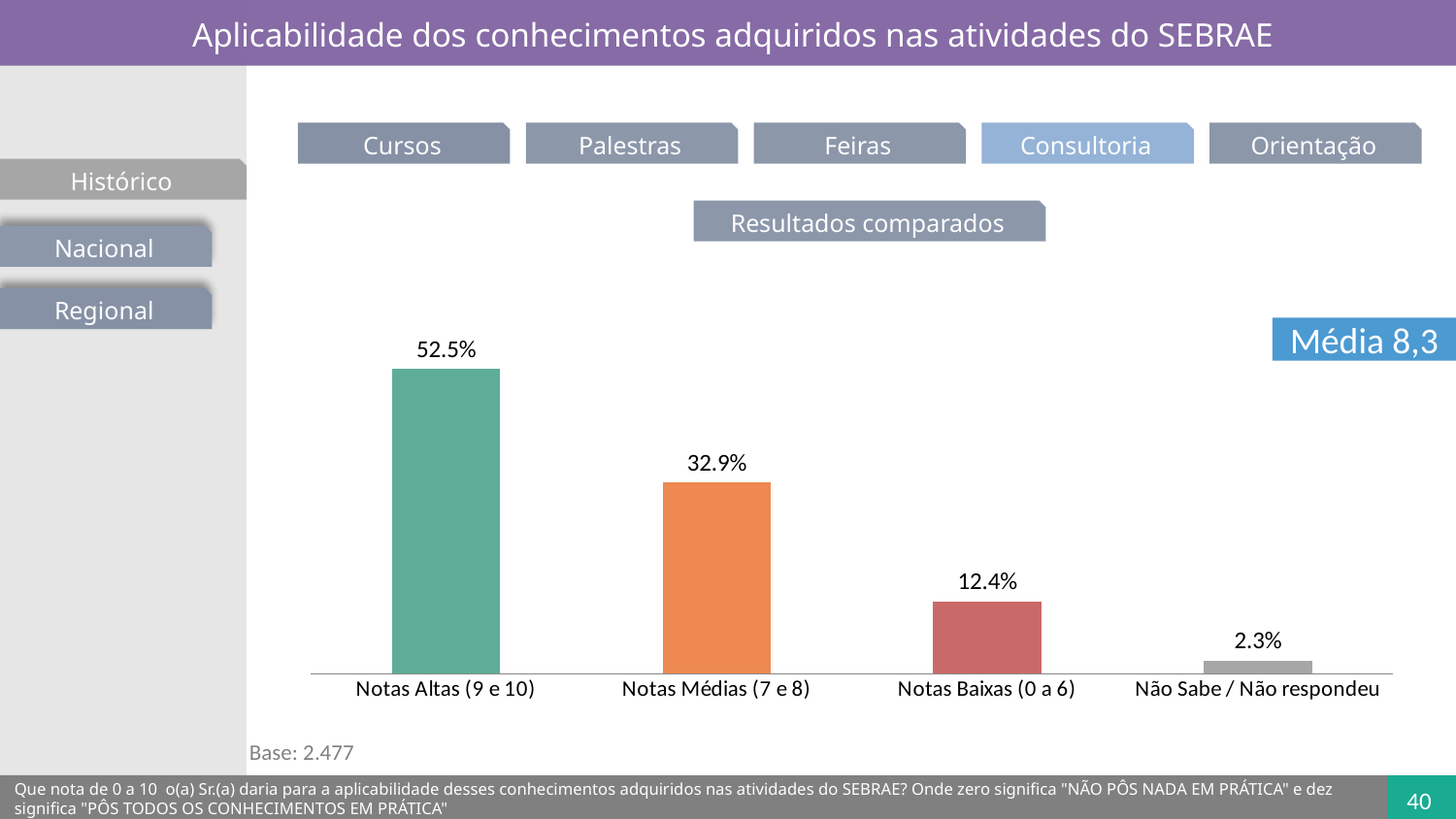
What is the difference between Notas Baixas (0 a 6) and Não Sabe / Não respondeu? 10.1% What is the value for Não Sabe / Não respondeu? 2.3% What is the difference between Notas Altas (9 e 10) and Notas Médias (7 e 8)? 19.6% What is the value for Notas Baixas (0 a 6)? 12.4% What is the value for Notas Altas (9 e 10)? 52.5% How many categories are shown in the chart? 4 What kind of chart is shown on the slide? Bar chart What is the value for Notas Médias (7 e 8)? 32.9% What average (Média) is shown on the slide? 8,3 Which category has the highest value? Notas Altas (9 e 10) Which is larger, Notas Médias (7 e 8) or Notas Baixas (0 a 6)? Notas Médias (7 e 8) Which category has the lowest value? Não Sabe / Não respondeu